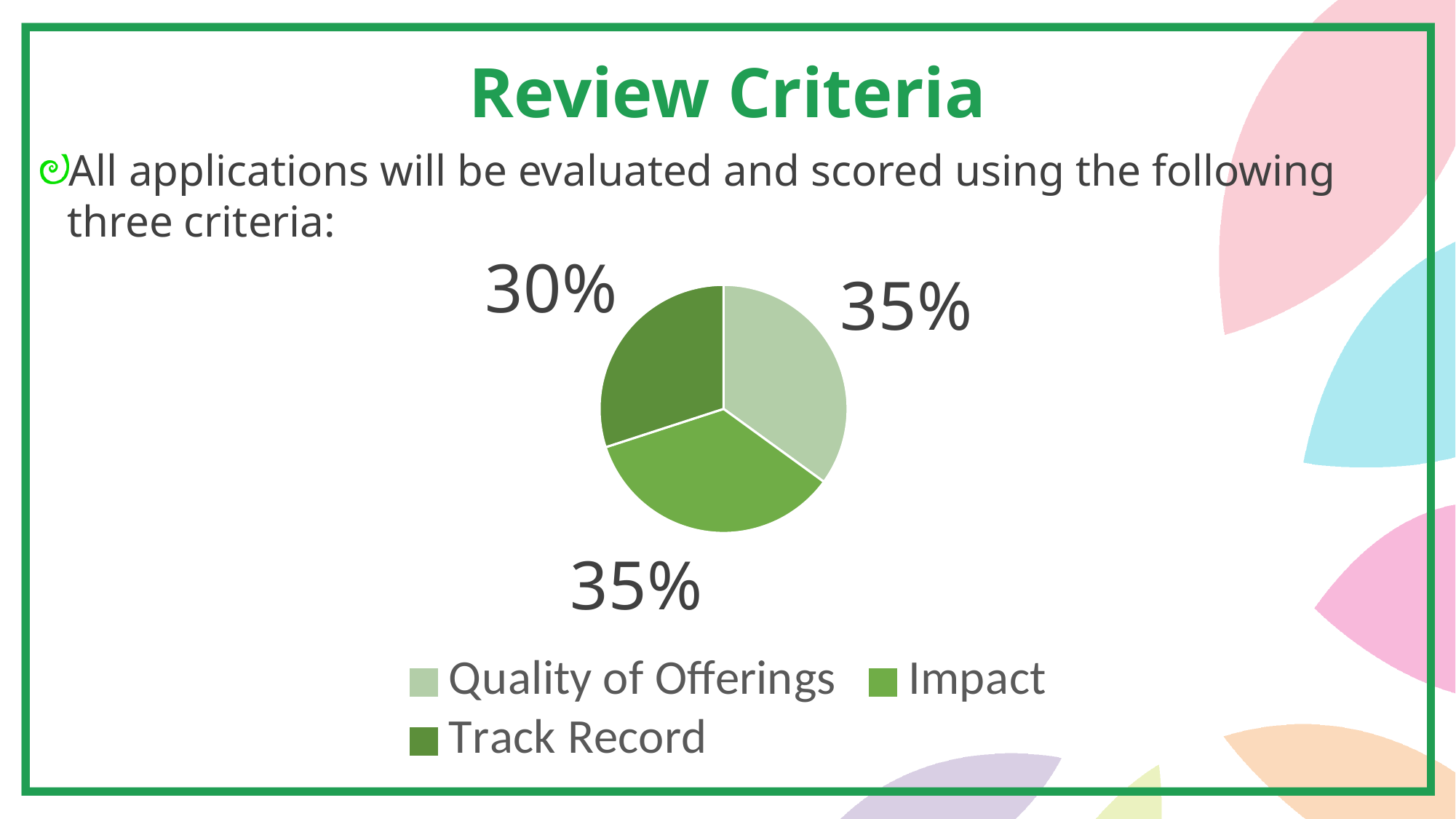
What share of the pie does Track Record represent? 30% How many slices does the pie chart have? 3 What type of chart is shown on the slide? pie chart Which criterion has the smallest slice of the pie? Track Record What is the difference between the Quality of Offerings share and the Track Record share? 5% Which is larger, the slice for Quality of Offerings or the slice for Track Record? Quality of Offerings Which is larger, the slice for Track Record or the slice for Impact? Impact What share of the pie does Quality of Offerings represent? 35% What share of the pie does Impact represent? 35% Which legend entry is shown in the lightest green? Quality of Offerings How many entries does the legend list? 3 Which legend entry is shown in the darkest green? Track Record